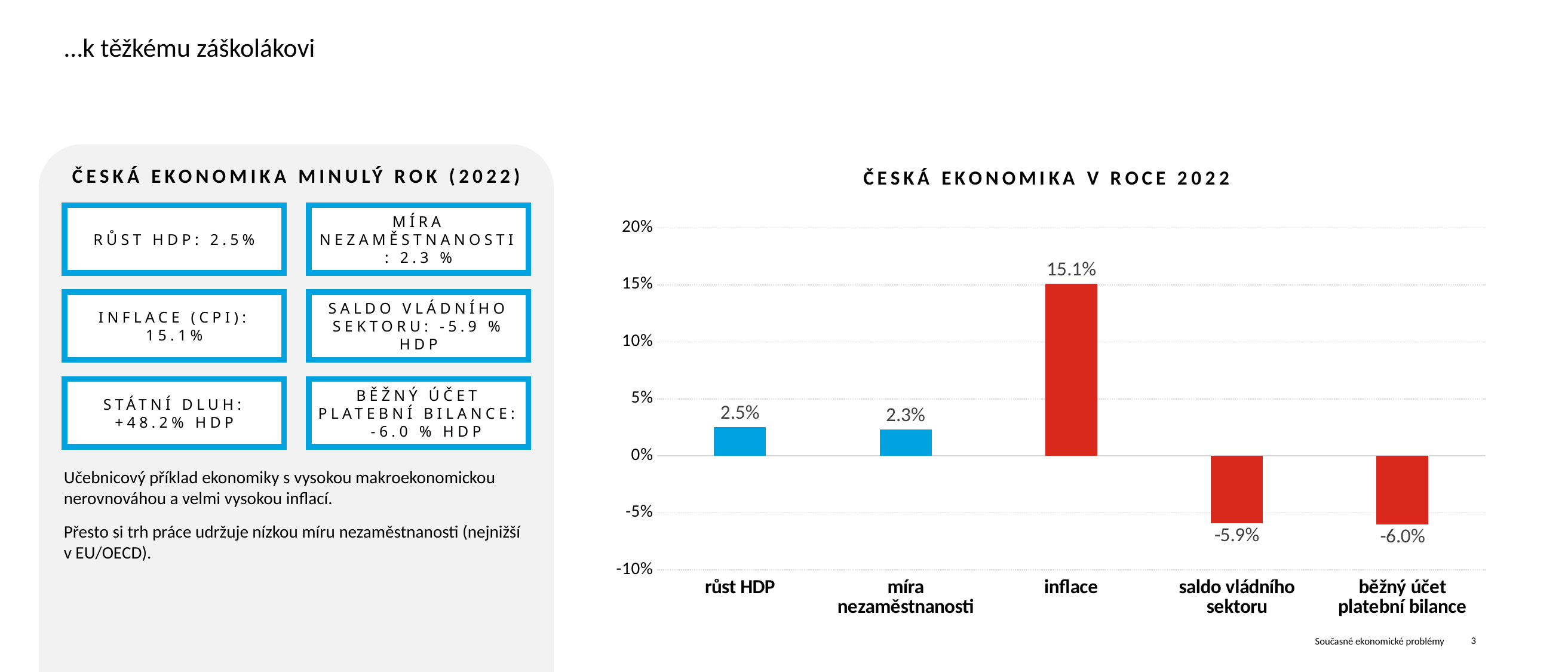
What is the value for inflace in the chart? 15.1% Which category has the highest value in the chart? inflace What is the value for růst HDP in the chart? 2.5% What kind of chart is shown on the slide? bar chart What is the difference between the value for inflace and the value for růst HDP? 12.6% What is the title of the chart? ČESKÁ EKONOMIKA V ROCE 2022 Is the value for inflace greater or less than 10%? greater What is the value for běžný účet platební bilance in the chart? -6.0% Which is larger, the value for růst HDP or the value for míra nezaměstnanosti? růst HDP Which category has the lowest value in the chart? běžný účet platební bilance How many categories are shown in the chart? 5 What is the value for saldo vládního sektoru in the chart? -5.9%